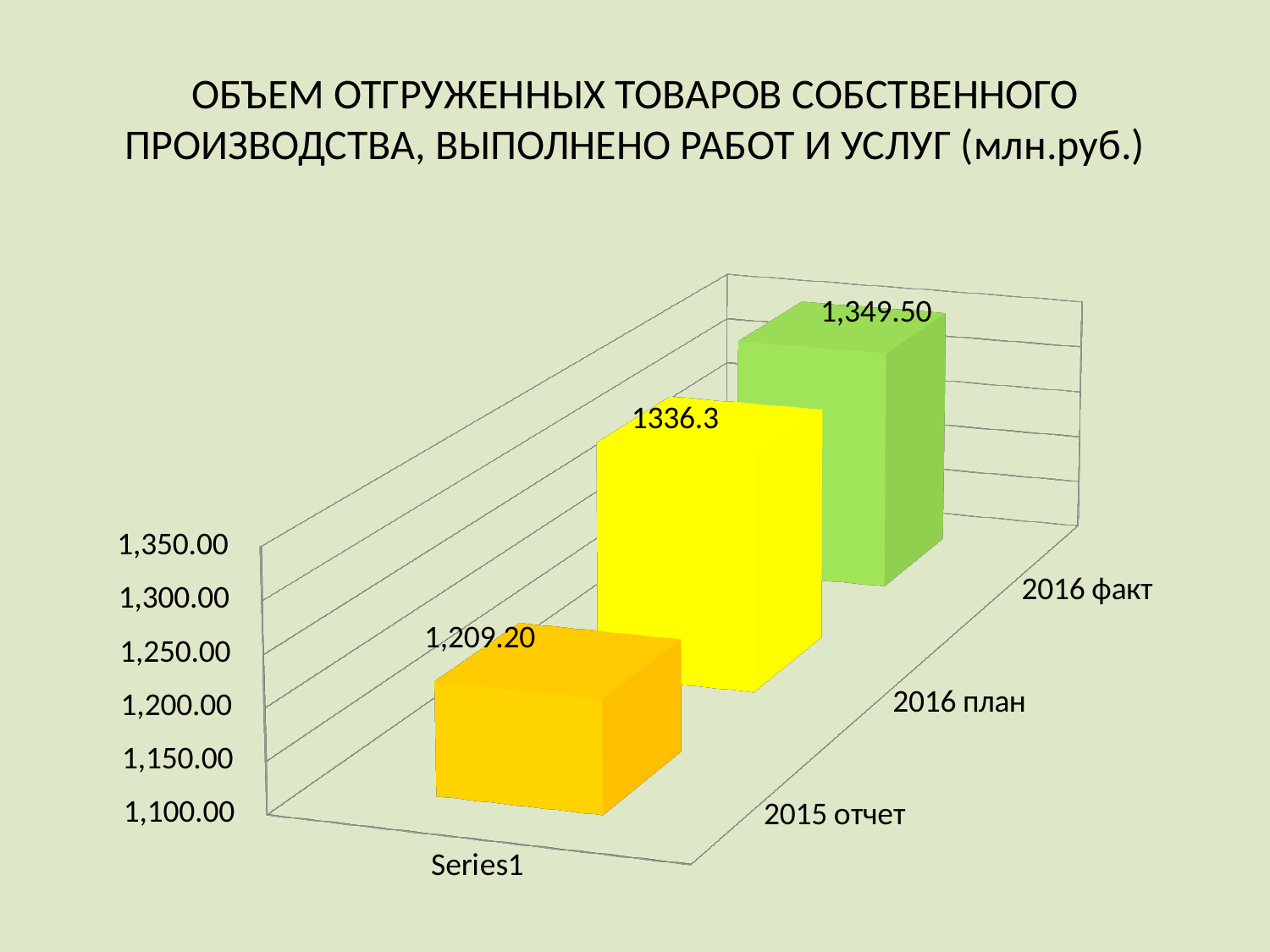
Which category has the lowest value? 2015 отчет What is the value for 2016 факт? 1,349.50 Which is larger, the value for 2016 план or the value for 2015 отчет? 2016 план Is the value for 2015 отчет greater or less than 1,250.00? less What kind of chart is shown on the slide? bar chart What is the value for 2015 отчет? 1,209.20 What is the difference between the values for 2016 факт and 2015 отчет? 140.30 How many categories are shown in the chart? 3 Which category has the highest value? 2016 факт Do the values rise or fall from 2015 отчет to 2016 факт? rise What is the difference between the values for 2016 план and 2015 отчет? 127.1 What is the value for 2016 план? 1336.3